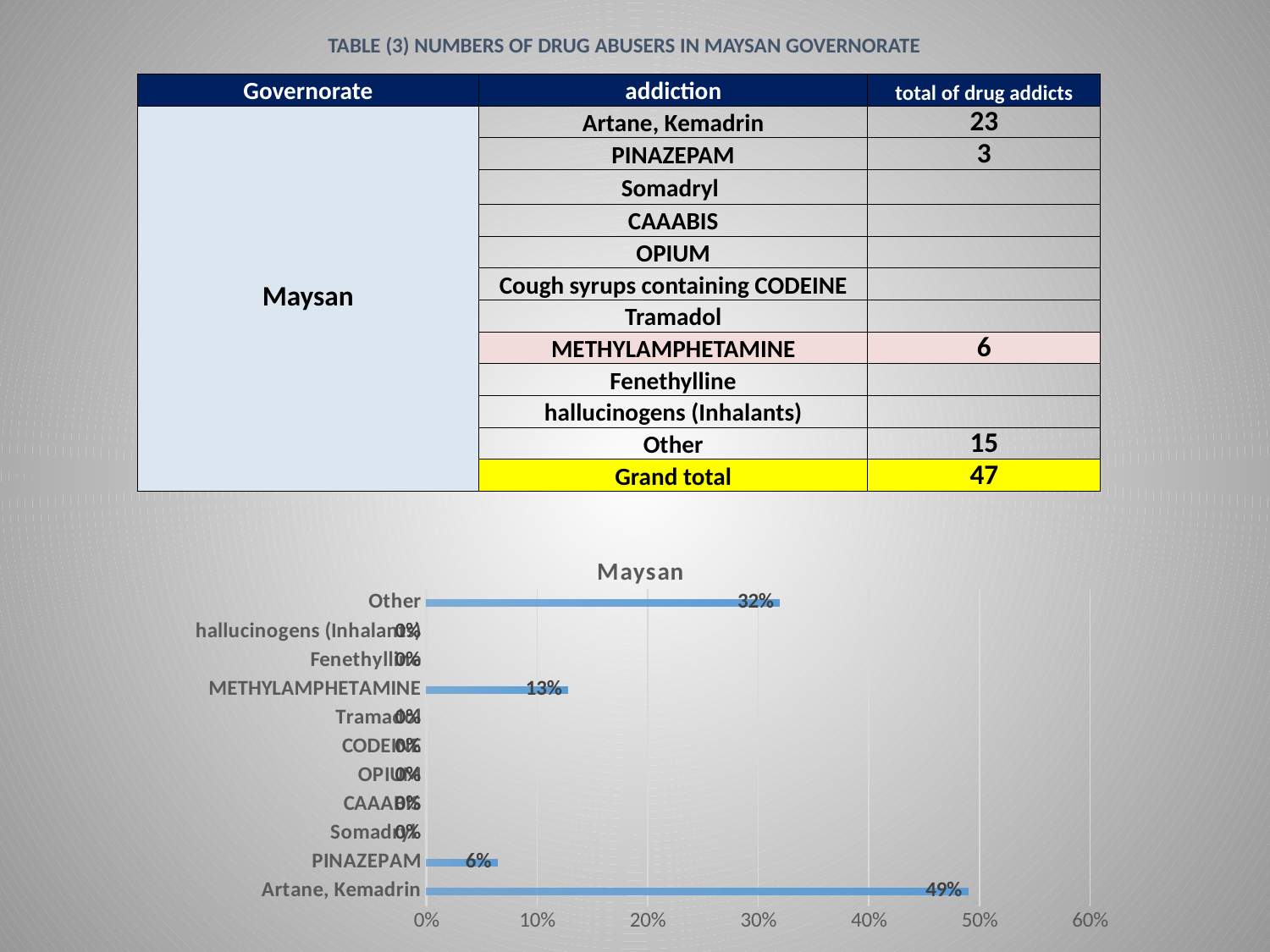
Which is larger in the chart, the value for METHYLAMPHETAMINE or the value for PINAZEPAM? METHYLAMPHETAMINE What is the title of the chart? Maysan How many categories are shown in the chart? 11 What kind of chart is shown on the slide? bar chart Is the value for Other in the chart greater or less than 40%? less What is the difference between the values for Artane, Kemadrin and Other in the chart? 17% What is the highest value shown on the chart's horizontal axis? 60% What is the value for METHYLAMPHETAMINE in the chart? 13% What is the value for PINAZEPAM in the chart? 6% What is the value for Artane, Kemadrin in the chart? 49% Which category has the highest value in the chart? Artane, Kemadrin What is the value for Other in the chart? 32%